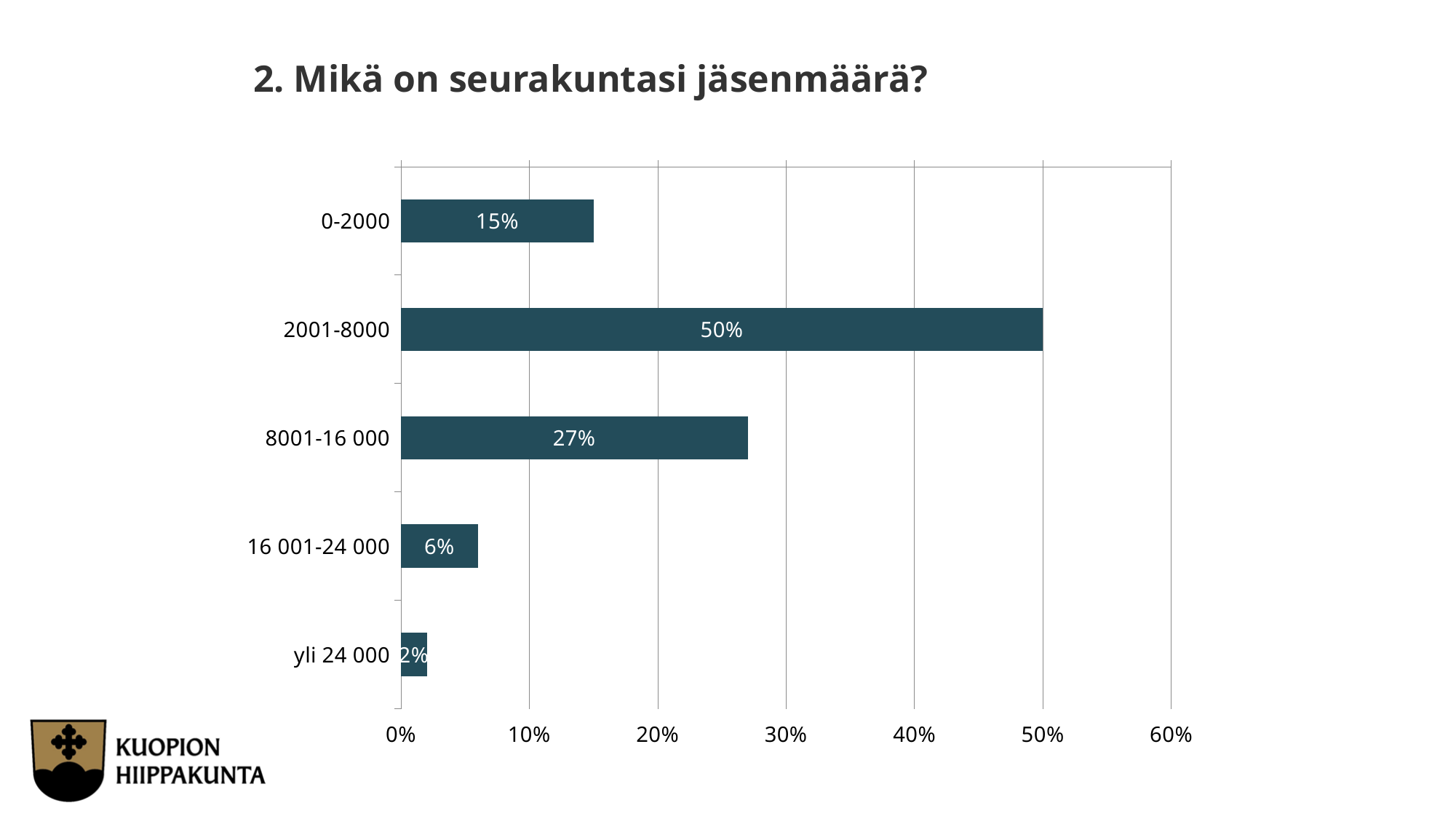
What is the title of the chart? 2. Mikä on seurakuntasi jäsenmäärä? What is the value for the yli 24 000 category? 2% What is the value for the 8001-16 000 category? 27% What is the value for the 0-2000 category? 15% Which category has the lowest value? yli 24 000 What kind of chart is shown on the slide? bar chart What is the value for the 2001-8000 category? 50% Which is larger, the value for 0-2000 or the value for 16 001-24 000? 0-2000 What is the difference between the values for 2001-8000 and 8001-16 000? 23% Is the value for 8001-16 000 greater or less than 20%? greater How many categories are shown in the chart? 5 Which category has the highest value? 2001-8000